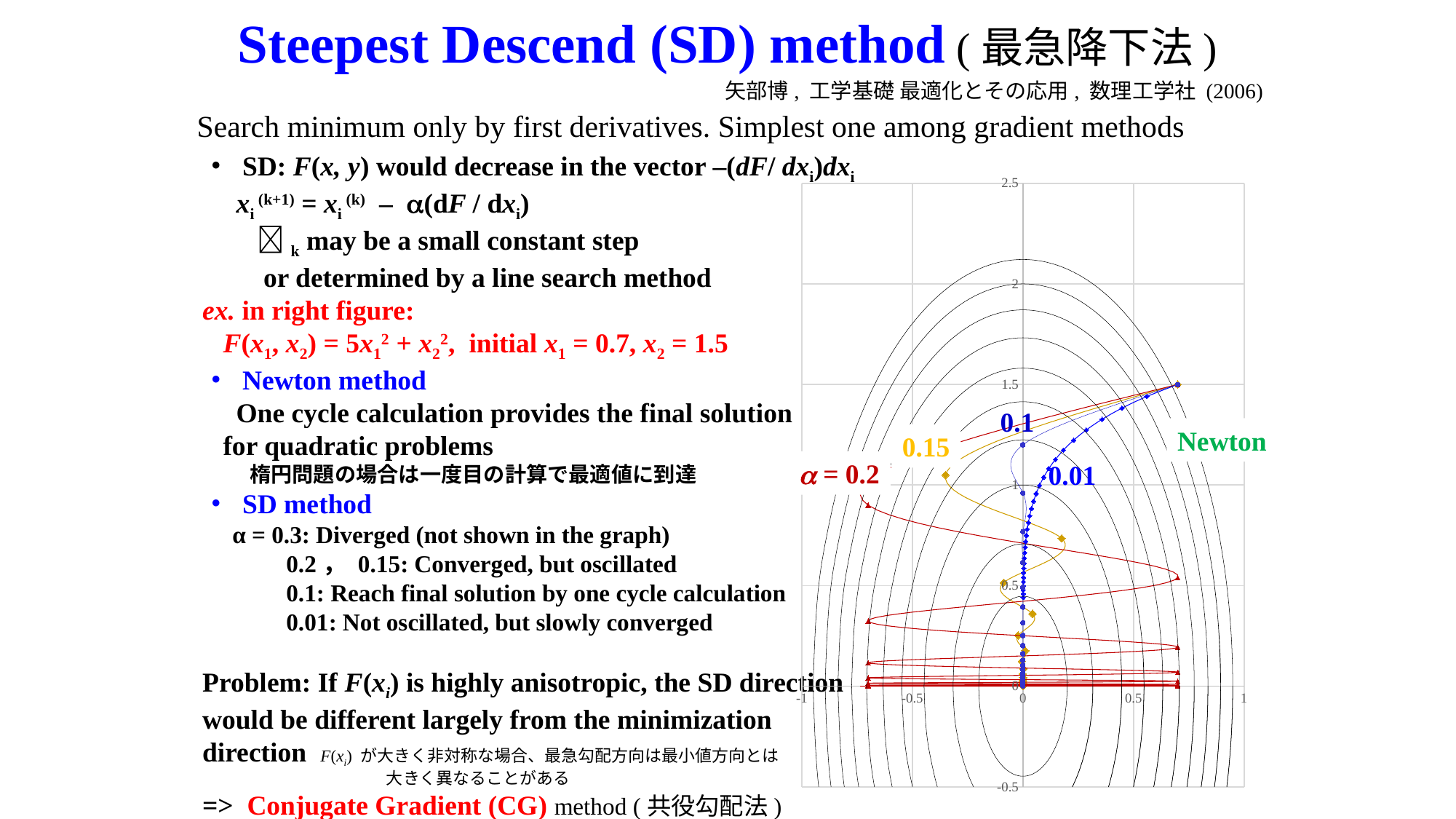
Which step size α is labelled on the gold/yellow trajectory in the chart? 0.15 How many labelled trajectories (step sizes plus Newton) are drawn on the chart? 5 Which method's trajectory is labelled in green on the chart? Newton What is the initial value of x2 for the trajectories shown in the chart? 1.5 What is the minimum value shown on the horizontal axis of the chart? -1 Which step size α is labelled on the red trajectory in the chart? 0.2 Which step size α produces the trajectory that oscillates most widely in the horizontal direction? 0.2 What kind of chart is shown on the right of the slide? A line/scatter plot of optimization trajectories over contour lines Is the horizontal coordinate of the starting point of the trajectories greater or less than 0.5? greater What is the maximum value shown on the vertical axis of the chart? 2.5 What is the initial value of x1 for the trajectories shown in the chart? 0.7 Which step size α produces the trajectory with the most closely spaced points along the vertical axis? 0.01